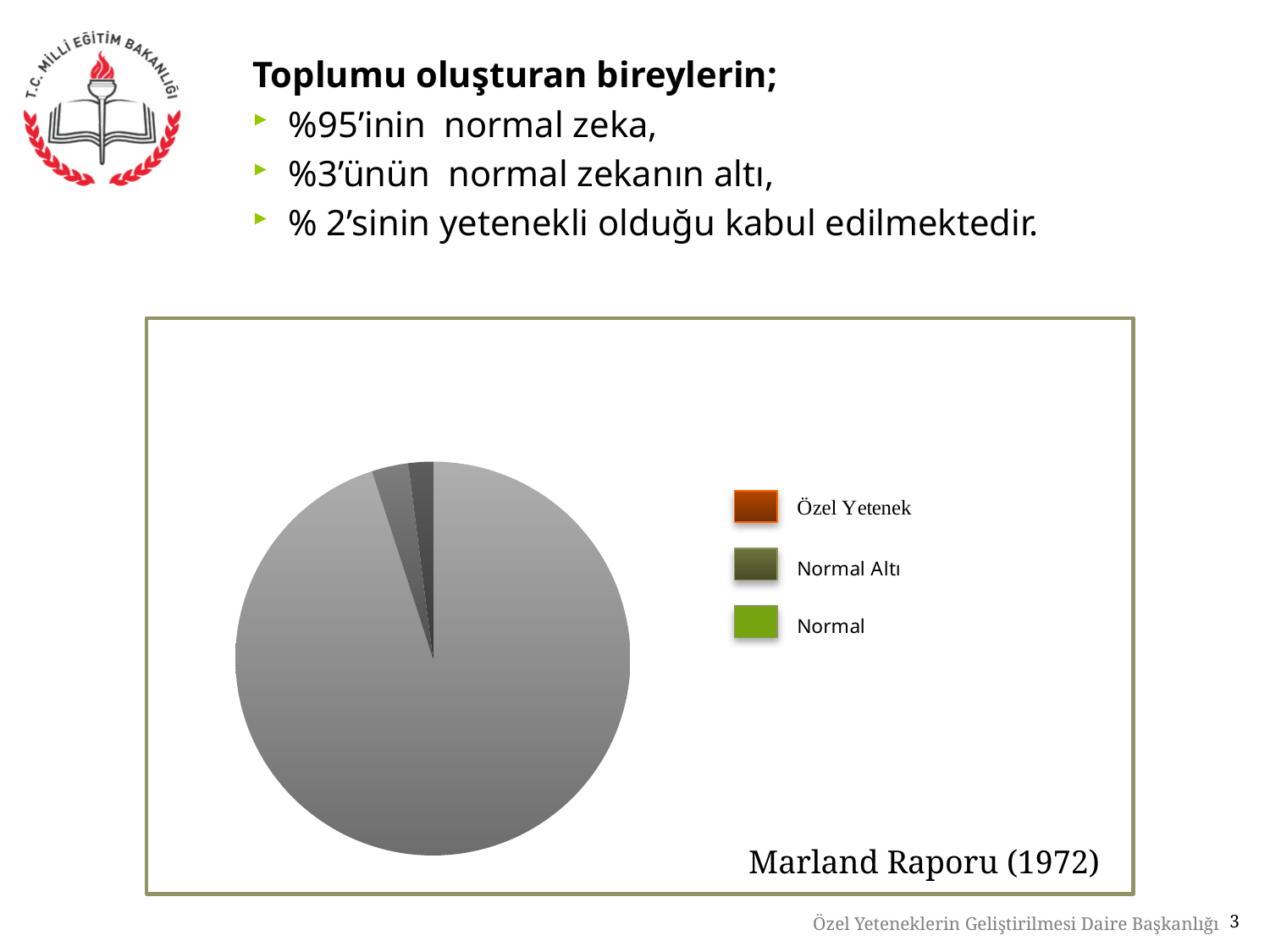
How many slices does the pie chart have? 3 How many entries does the legend of the pie chart list? 3 Which slice is larger in the pie chart, Normal or Normal Altı? Normal What source is cited in the bottom-right corner of the chart area? Marland Raporu (1972) Which legend entry is shown with an orange colour swatch? Özel Yetenek Which slice is larger in the pie chart, Normal or Özel Yetenek? Normal Which category has the smallest slice in the pie chart? Özel Yetenek What kind of chart is shown on the slide? pie chart Which category has the largest slice in the pie chart? Normal